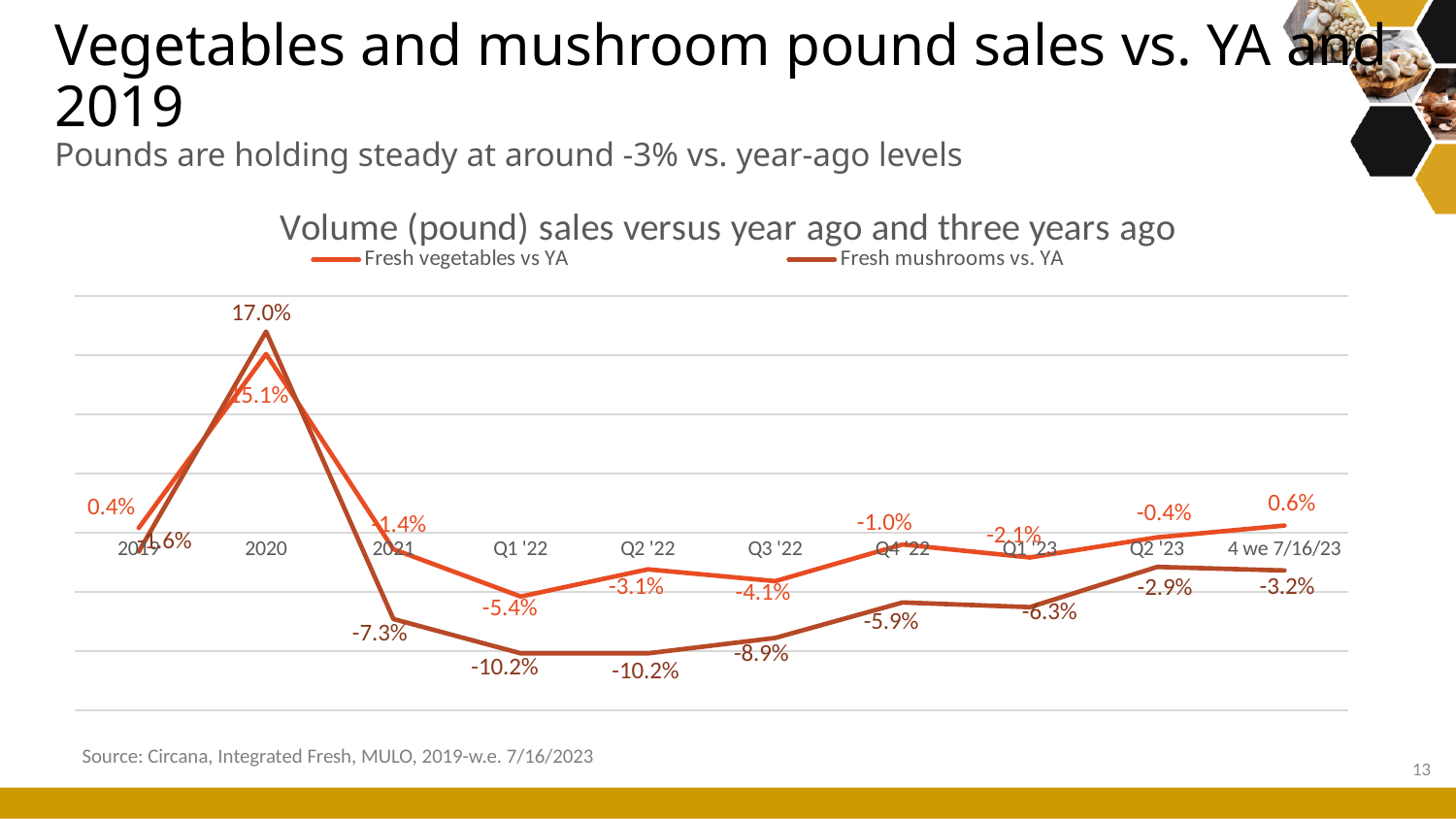
How many series does the chart's legend list? 2 What is the value for Fresh mushrooms vs. YA in Q2 '23? -2.9% In 2020, how many percentage points higher is Fresh mushrooms vs. YA than Fresh vegetables vs YA? 1.9 percentage points In which period is the Fresh mushrooms vs. YA value highest? 2020 In which period is the Fresh vegetables vs YA value lowest? Q1 '22 What kind of chart is shown on the slide? Line chart What is the value for Fresh vegetables vs YA for the 4 we 7/16/23 period? 0.6% In Q4 '22, which series has the higher value, Fresh vegetables vs YA or Fresh mushrooms vs. YA? Fresh vegetables vs YA How many periods are shown on the x axis of the chart? 10 What is the value for Fresh mushrooms vs. YA in Q3 '22? -8.9% What is the value for Fresh vegetables vs YA in Q1 '22? -5.4% In Q1 '22, what is the difference between the Fresh vegetables vs YA value and the Fresh mushrooms vs. YA value? 4.8 percentage points